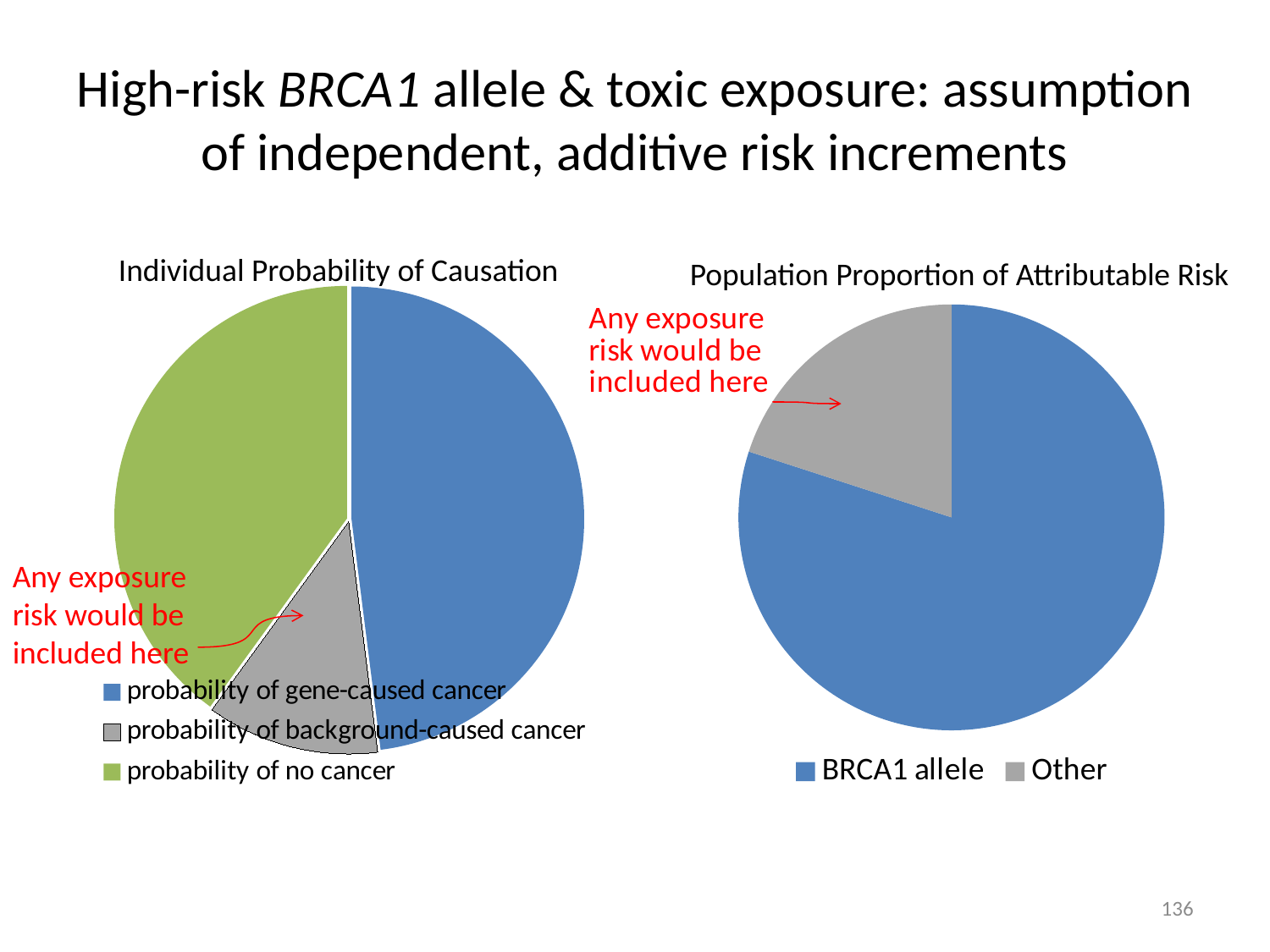
In the "Individual Probability of Causation" chart, how many entries does the legend list? 3 In the "Individual Probability of Causation" chart, how many slices does the pie have? 3 What kind of chart is the "Population Proportion of Attributable Risk" chart? pie chart In the "Individual Probability of Causation" chart, which is larger: the slice for probability of gene-caused cancer or the slice for probability of no cancer? probability of gene-caused cancer In the "Population Proportion of Attributable Risk" chart, which category has the larger slice? BRCA1 allele In the "Individual Probability of Causation" chart, what colour is the slice for probability of no cancer? green In the "Population Proportion of Attributable Risk" chart, which is smaller: the BRCA1 allele slice or the Other slice? Other In the "Individual Probability of Causation" chart, which category has the smallest slice? probability of background-caused cancer What kind of chart is the "Individual Probability of Causation" chart? pie chart In the "Population Proportion of Attributable Risk" chart, how many entries does the legend list? 2 In the "Population Proportion of Attributable Risk" chart, how many slices does the pie have? 2 In the "Individual Probability of Causation" chart, which category has the largest slice? probability of gene-caused cancer